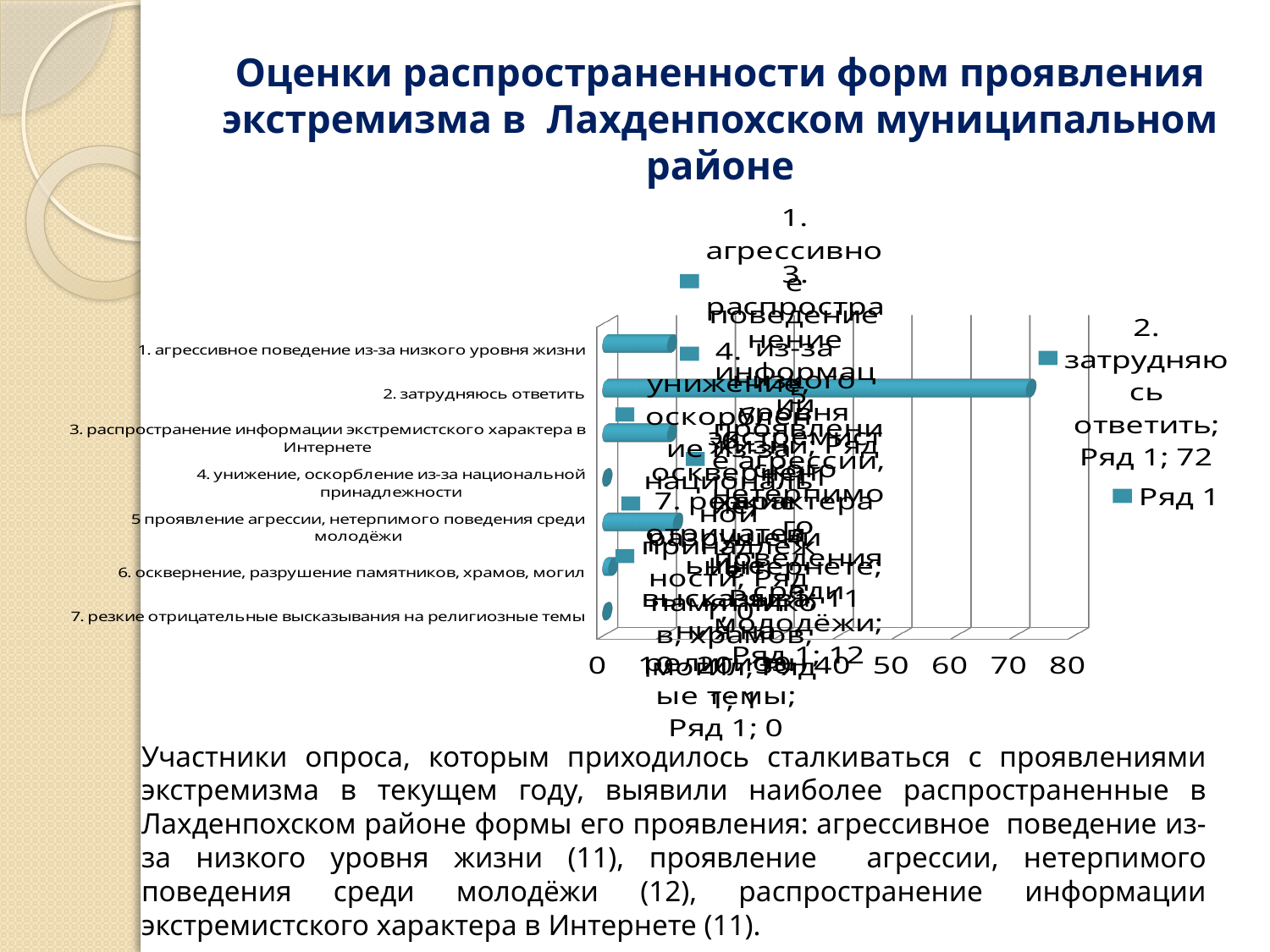
How many categories are plotted in the chart? 7 Is the value for "6. осквернение, разрушение памятников, храмов, могил" greater or less than 10? less What is the value for "5 проявление агрессии, нетерпимого поведения среди молодёжи"? 12 What is the value for "2. затрудняюсь ответить"? 72 What is the difference between the values for "2. затрудняюсь ответить" and "5 проявление агрессии, нетерпимого поведения среди молодёжи"? 60 Which is larger: the value for "1. агрессивное поведение из-за низкого уровня жизни" or for "6. осквернение, разрушение памятников, храмов, могил"? 1. агрессивное поведение из-за низкого уровня жизни What is the name of the series shown in the legend? Ряд 1 What is the value for "7. резкие отрицательные высказывания на религиозные темы"? 0 What kind of chart is shown on the slide? bar chart Is the value for "2. затрудняюсь ответить" greater or less than 50? greater How many series does the chart legend list? 1 Which category has the highest value in the chart? 2. затрудняюсь ответить